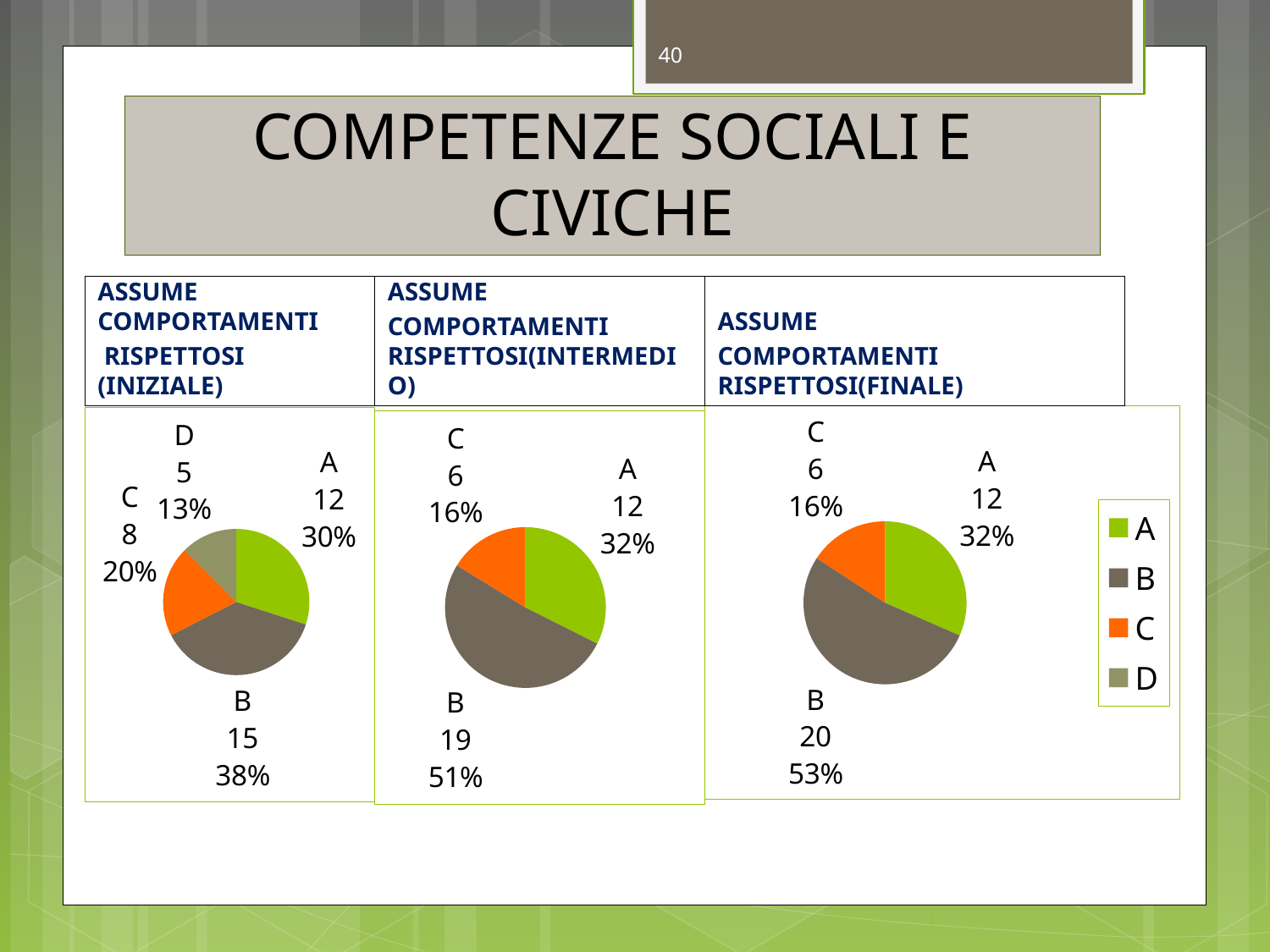
How many entries does the legend on the right of the slide list? 4 In the FINALE pie chart, which category has the largest value? B In the INIZIALE pie chart, which category has the smallest value? D In the INTERMEDIO pie chart, what is the value for category B? 19 In the FINALE pie chart, which is larger, the value for A or the value for C? A In the INTERMEDIO pie chart, what share of the pie does category C represent? 16% In the FINALE pie chart, what share of the pie does category B represent? 53% What kind of chart is used in the INIZIALE panel? Pie chart In the INIZIALE pie chart, what is the value for category B? 15 In the INIZIALE pie chart, what share of the pie does category D represent? 13% In the INIZIALE pie chart, what is the difference between the values for B and A? 3 How many categories are shown in the INTERMEDIO pie chart? 3